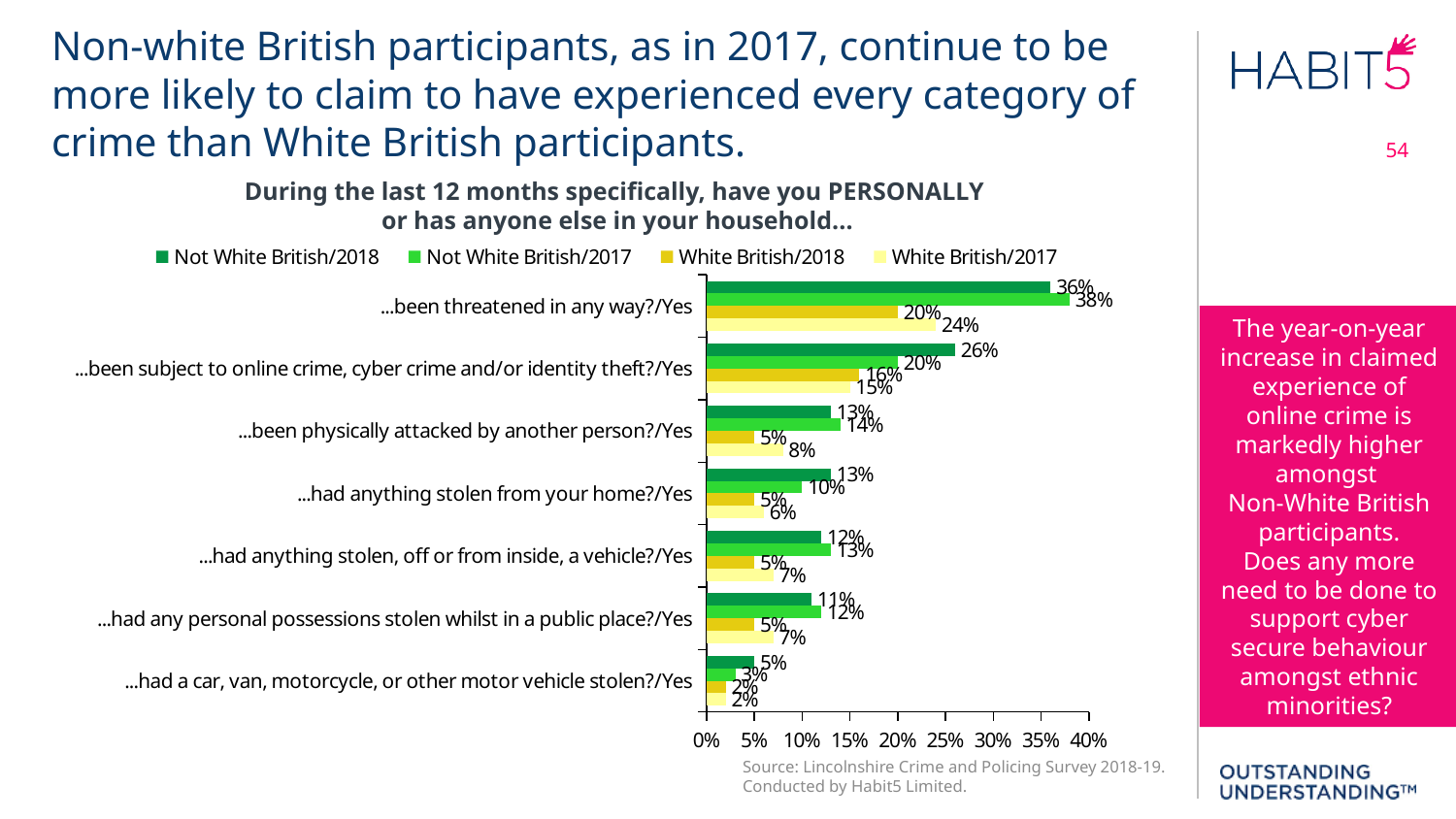
What is the value for Not White British/2017 for "…had a car, van, motorcycle, or other motor vehicle stolen?/Yes"? 3% Which category has the highest value for Not White British/2018? …been threatened in any way?/Yes What is the value for Not White British/2018 for "…been subject to online crime, cyber crime and/or identity theft?/Yes"? 26% What kind of chart is shown on the slide? Bar chart For "…had anything stolen from your home?/Yes", which is larger: Not White British/2018 or Not White British/2017? Not White British/2018 Which category has the lowest value for White British/2018? …had a car, van, motorcycle, or other motor vehicle stolen?/Yes How many series does the legend list? 4 Which series is shown in dark green in the legend? Not White British/2018 What is the difference between Not White British/2018 and White British/2018 for "…been subject to online crime, cyber crime and/or identity theft?/Yes"? 10% What is the value for White British/2018 for "…been physically attacked by another person?/Yes"? 5% What is the value for White British/2017 for "…been threatened in any way?/Yes"? 24% How many categories are shown on the chart? 7